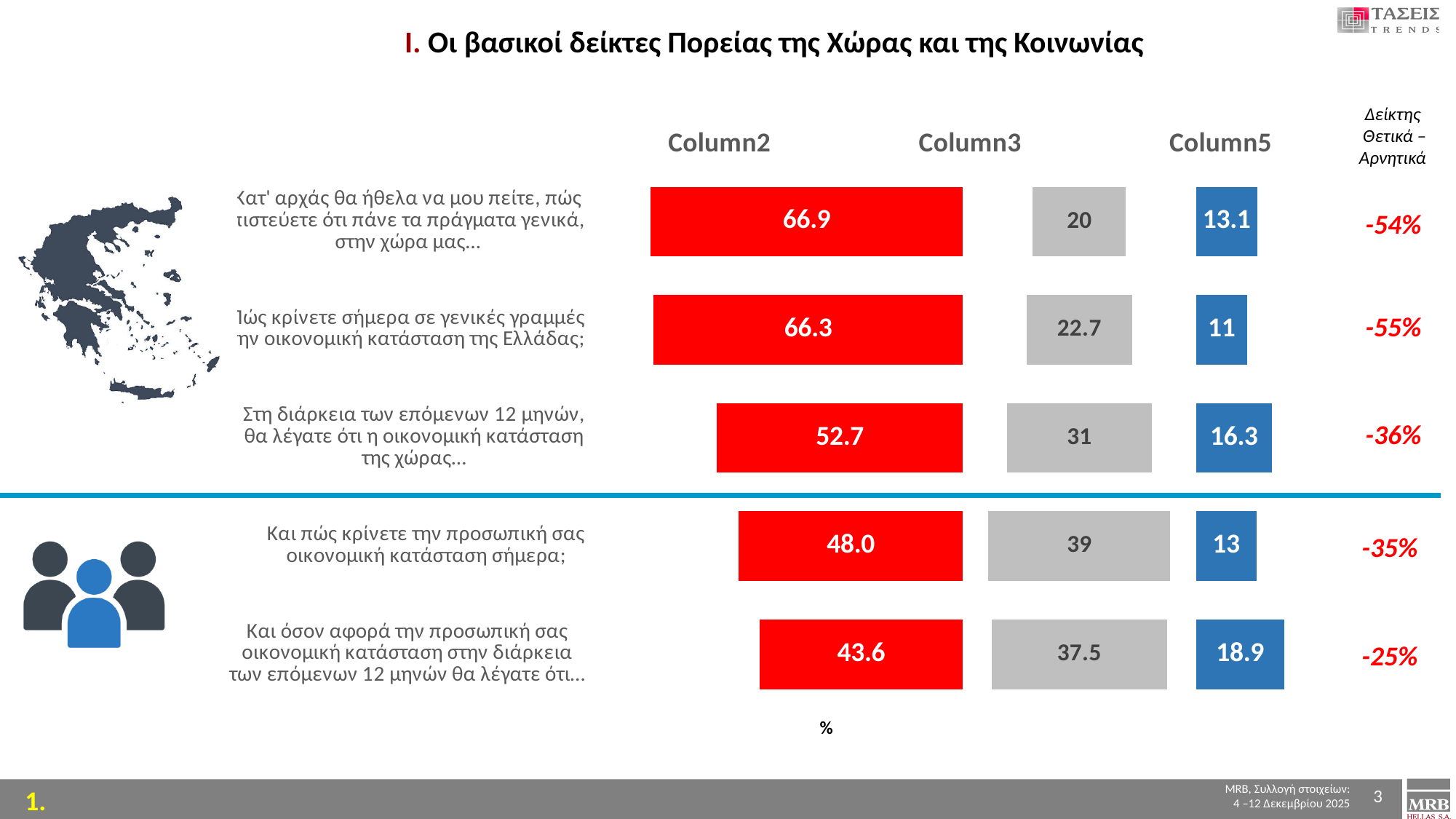
What is the Column5 value for the row "Στη διάρκεια των επόμενων 12 μηνών, θα λέγατε ότι η οικονομική κατάσταση της χώρας..."? 16.3 What is the difference between the Column2 value and the Column3 value for the row "Και όσον αφορά την προσωπική σας οικονομική κατάσταση στην διάρκεια των επόμενων 12 μηνών θα λέγατε ότι..."? 6.1 Which row has the highest Column2 value? Κατ' αρχάς θα ήθελα να μου πείτε, πώς πιστεύετε ότι πάνε τα πράγματα γενικά, στην χώρα μας... Which is larger: the Column3 value for "Και πώς κρίνετε την προσωπική σας οικονομική κατάσταση σήμερα;" or the Column3 value for "Στη διάρκεια των επόμενων 12 μηνών, θα λέγατε ότι η οικονομική κατάσταση της χώρας..."? Και πώς κρίνετε την προσωπική σας οικονομική κατάσταση σήμερα; What is the total of the stacked bar for the row "Κατ' αρχάς θα ήθελα να μου πείτε, πώς πιστεύετε ότι πάνε τα πράγματα γενικά, στην χώρα μας..."? 100 How many series does the chart show? 3 Which row has the lowest Column5 value? Πώς κρίνετε σήμερα σε γενικές γραμμές την οικονομική κατάσταση της Ελλάδας; What kind of chart is shown on the slide? Stacked bar chart What is the Column2 value for the row "Πώς κρίνετε σήμερα σε γενικές γραμμές την οικονομική κατάσταση της Ελλάδας;"? 66.3 What is the Δείκτης Θετικά – Αρνητικά value shown for the row "Και όσον αφορά την προσωπική σας οικονομική κατάσταση στην διάρκεια των επόμενων 12 μηνών θα λέγατε ότι..."? -25% What is the Column3 value for the row "Και πώς κρίνετε την προσωπική σας οικονομική κατάσταση σήμερα;"? 39 How many rows (questions) are plotted in the chart? 5